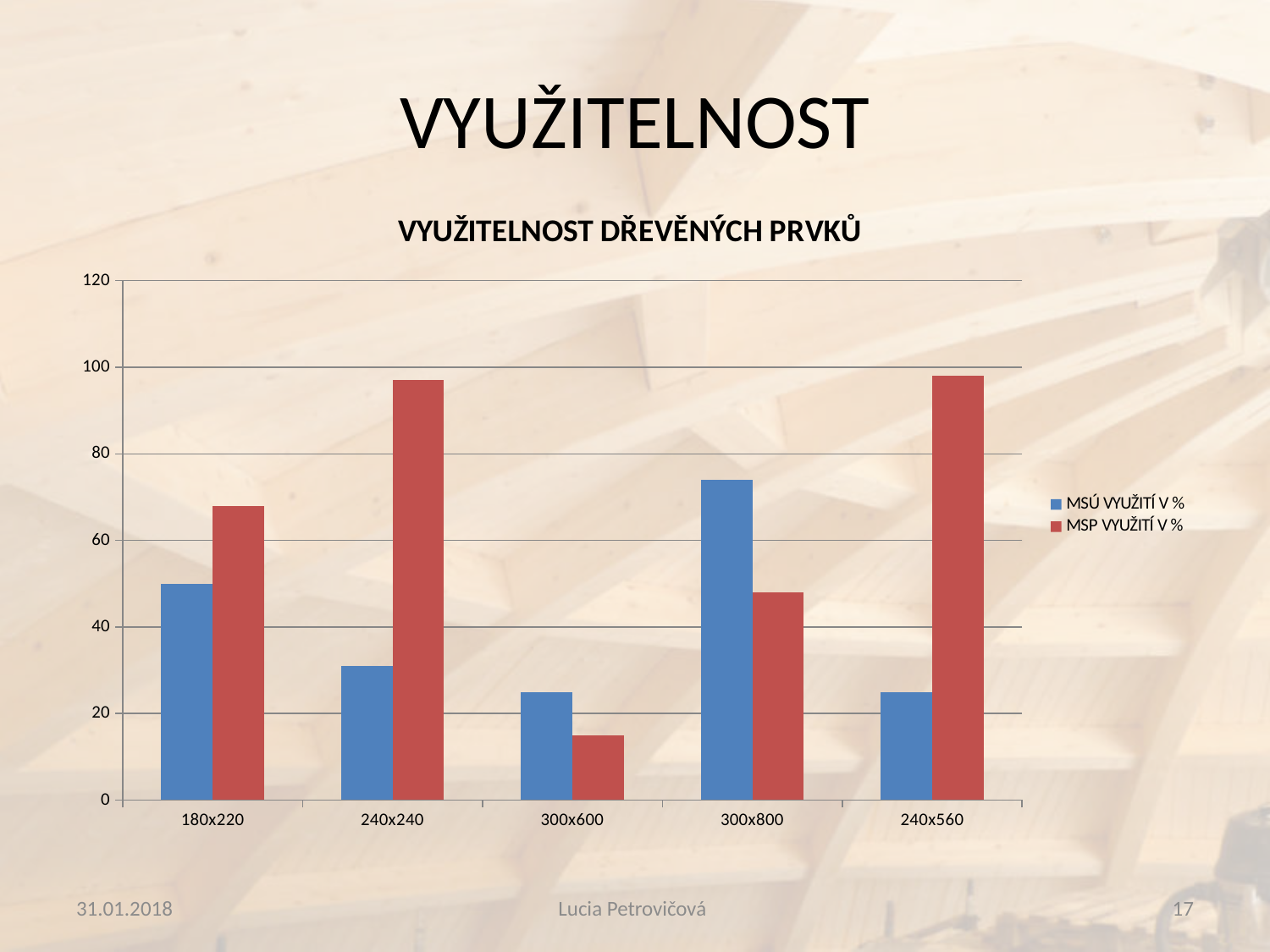
Which category has the highest value for MSÚ VYUŽITÍ V %? 300x800 Which colour represents MSÚ VYUŽITÍ V % in the chart? blue How many series does the legend list? 2 How many categories are shown on the x axis? 5 Is the MSP VYUŽITÍ V % value for 300x600 greater or less than 20? less What is the title of the chart? VYUŽITELNOST DŘEVĚNÝCH PRVKŮ Is the MSÚ VYUŽITÍ V % value for 240x240 greater or less than 40? less For 300x600, which series has the larger value, MSÚ VYUŽITÍ V % or MSP VYUŽITÍ V %? MSÚ VYUŽITÍ V % Is the MSP VYUŽITÍ V % value for 240x240 greater or less than 80? greater Which category has the lowest value for MSP VYUŽITÍ V %? 300x600 For 180x220, which series has the larger value, MSÚ VYUŽITÍ V % or MSP VYUŽITÍ V %? MSP VYUŽITÍ V % What kind of chart is shown on the slide? bar chart